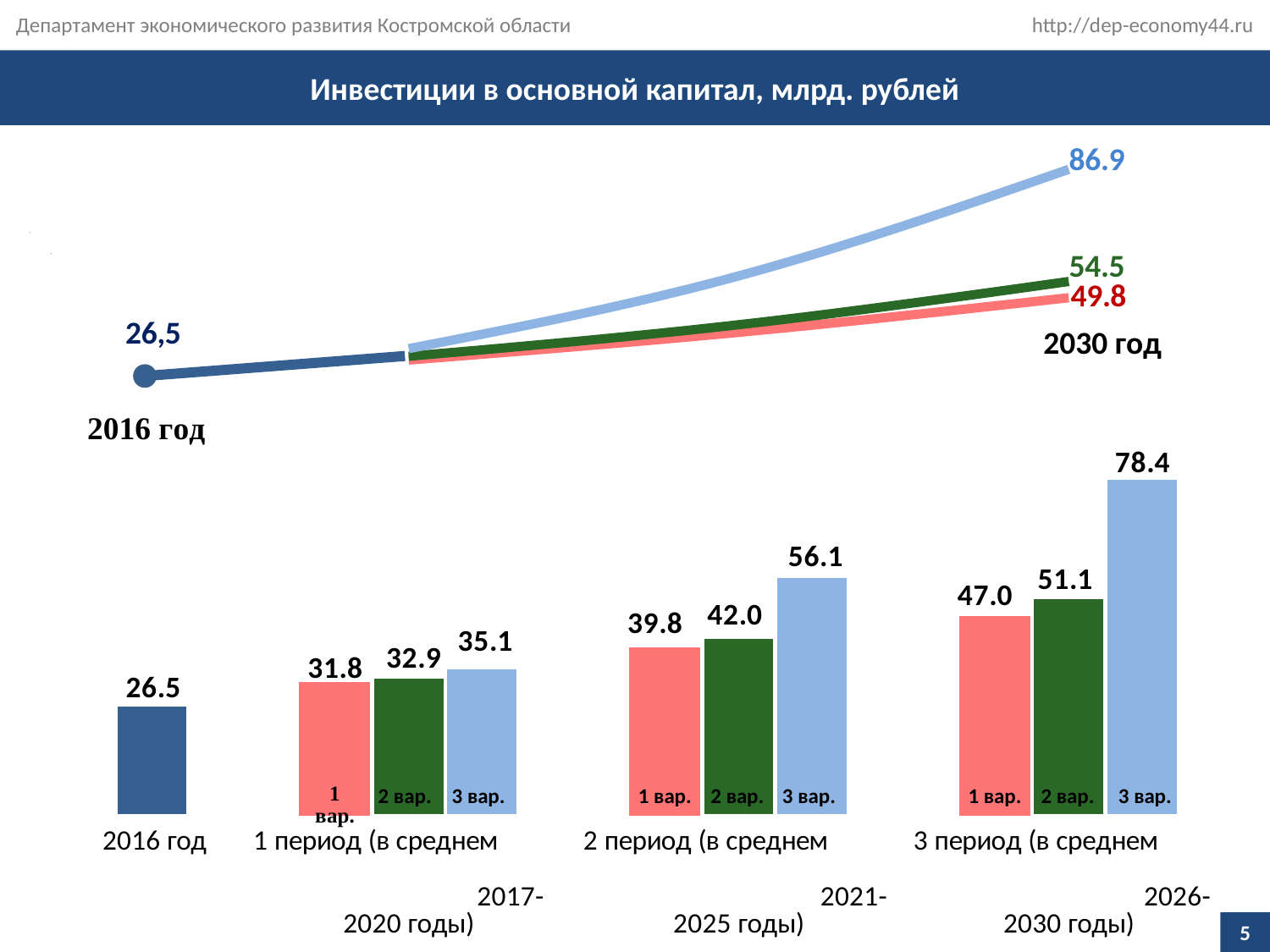
In the top line chart, what is the value of the light blue line in 2030 год? 86.9 In the top line chart, do the values rise or fall from 2016 год to 2030 год? Rise In the bottom bar chart, which bar has the lowest value? 2016 год (26.5) In the bottom bar chart, which is larger: 2 вар. in 2 период or 3 вар. in 1 период? 2 вар. in 2 период (42.0) In the top line chart, what is the value shown for 2016 год? 26,5 In the bottom bar chart, which bar has the highest value? 3 вар. in 3 период (78.4) In the top line chart, what is the difference between the green line value (54.5) and the red line value (49.8) in 2030 год? 4.7 In the bottom bar chart, what is the value for 3 вар. in 3 период (2026-2030 годы)? 78.4 In the bottom bar chart, what is the value for 1 вар. in 2 период (2021-2025 годы)? 39.8 In the bottom bar chart, what is the value for 2016 год? 26.5 In the bottom bar chart, what is the difference between 3 вар. and 1 вар. in 3 период? 31.4 What kind of chart is the bottom chart on the slide? Bar chart